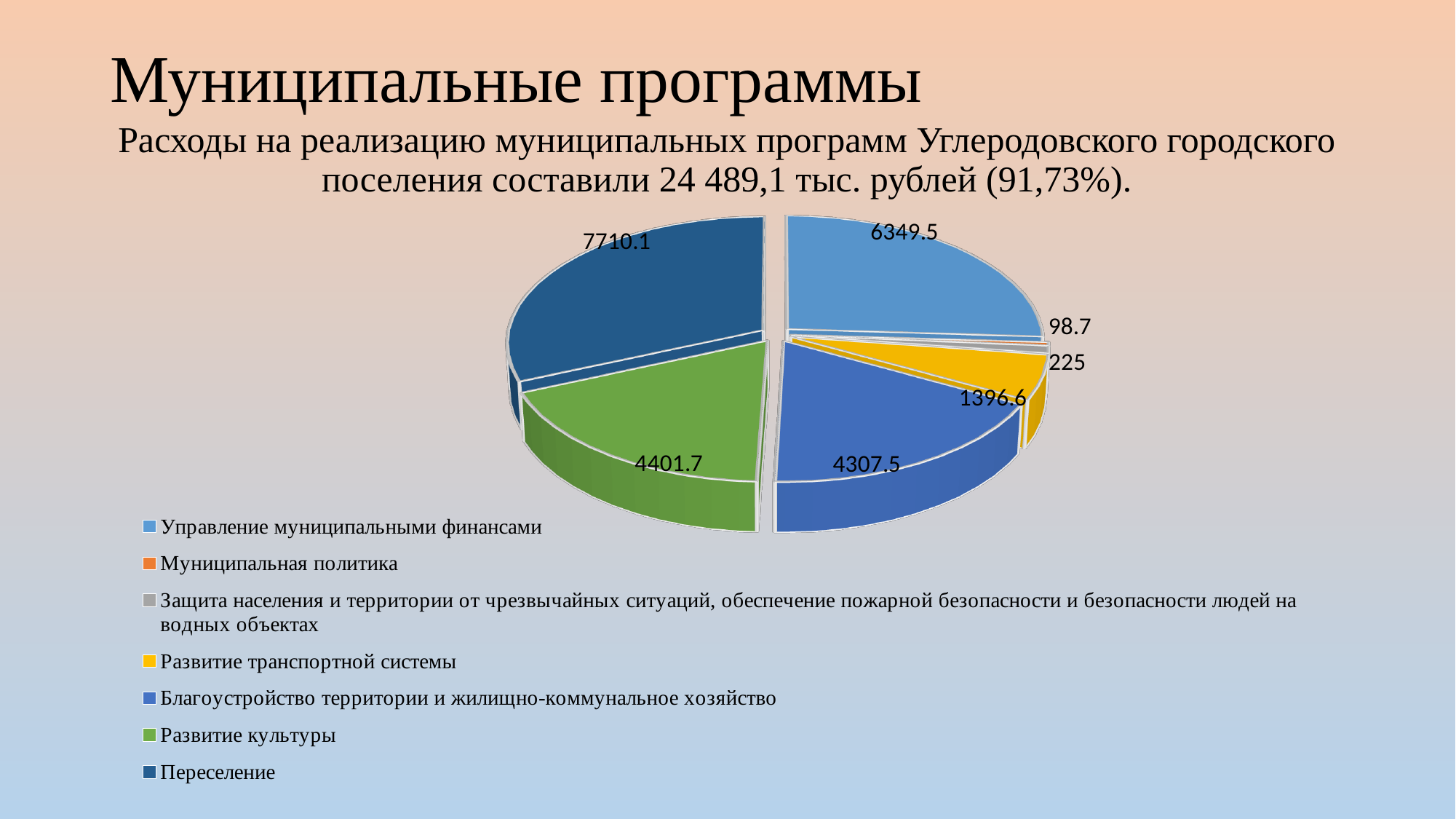
What colour is the slice for Развитие культуры? green What is the value for Управление муниципальными финансами? 6349.5 Which is larger: the value for Развитие транспортной системы or the value for Защита населения и территории от чрезвычайных ситуаций? Развитие транспортной системы What is the value for Благоустройство территории и жилищно-коммунальное хозяйство? 4307.5 What is the difference between the values for Развитие культуры and Благоустройство территории и жилищно-коммунальное хозяйство? 94.2 What type of chart is shown on the slide? pie chart What is the difference between the values for Переселение and Управление муниципальными финансами? 1360.6 What is the value for Развитие транспортной системы? 1396.6 What is the value for Переселение? 7710.1 How many slices does the pie chart have? 7 Which category has the smallest slice of the pie? Муниципальная политика Which category has the largest slice of the pie? Переселение